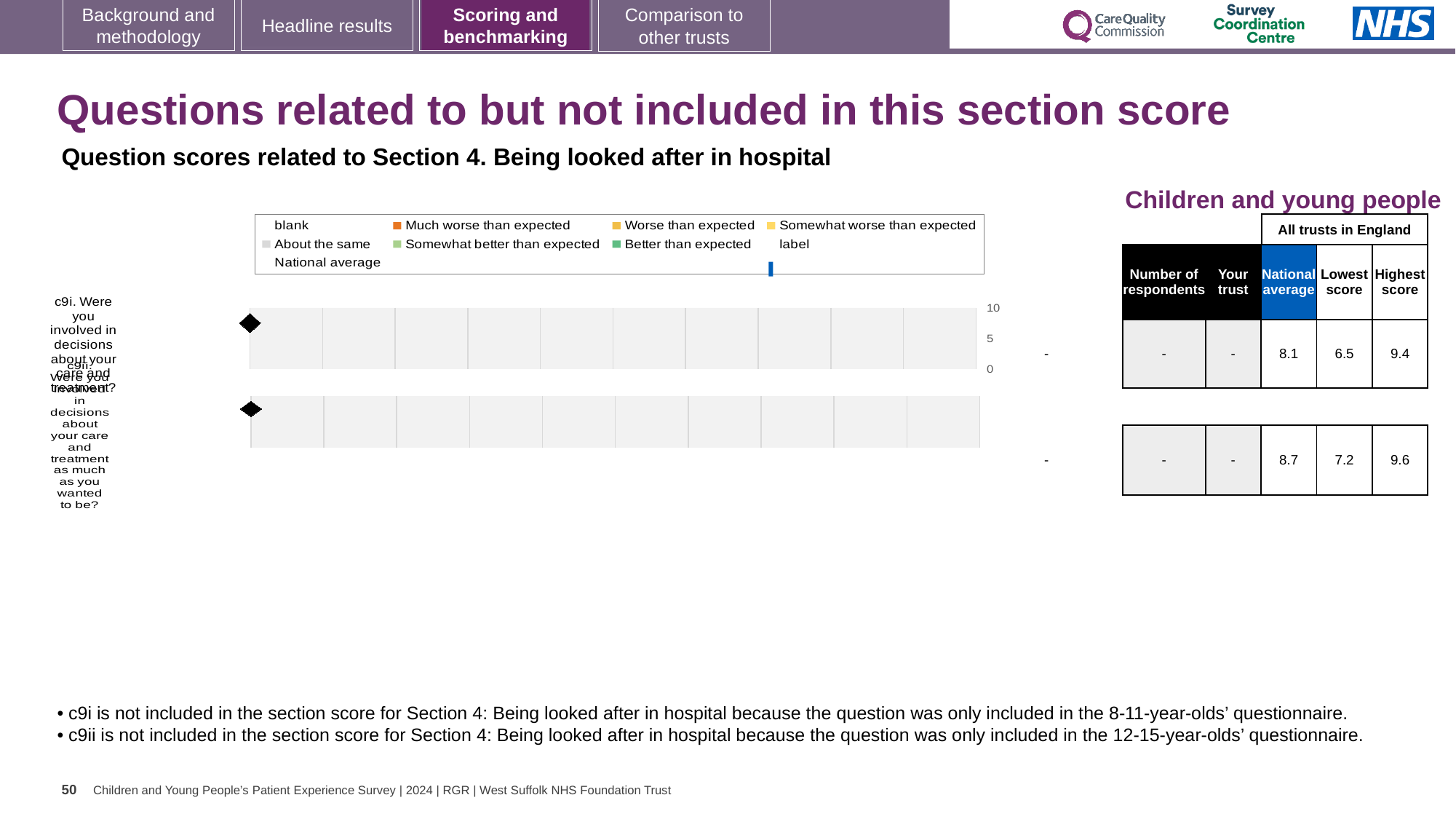
In the table, what is the national average for c9ii (the second row)? 8.7 In the table, what is the difference between the national averages of c9ii and c9i? 0.6 What kind of chart is shown on the slide? bar chart In the table, which row has the higher national average, c9i or c9ii? c9ii In the table, what is the difference between the highest score and the lowest score for c9i (the first row)? 2.9 In the table, what is the lowest score for c9i (the first row)? 6.5 In the table, what is the highest score for c9ii (the second row)? 9.6 How many entries does the chart's legend list? 9 What is the title of the table to the right of the chart? Children and young people What is the highest value shown on the chart's axis? 10 In the table, what is the national average for c9i (the first row)? 8.1 How many question categories are plotted on the chart? 2